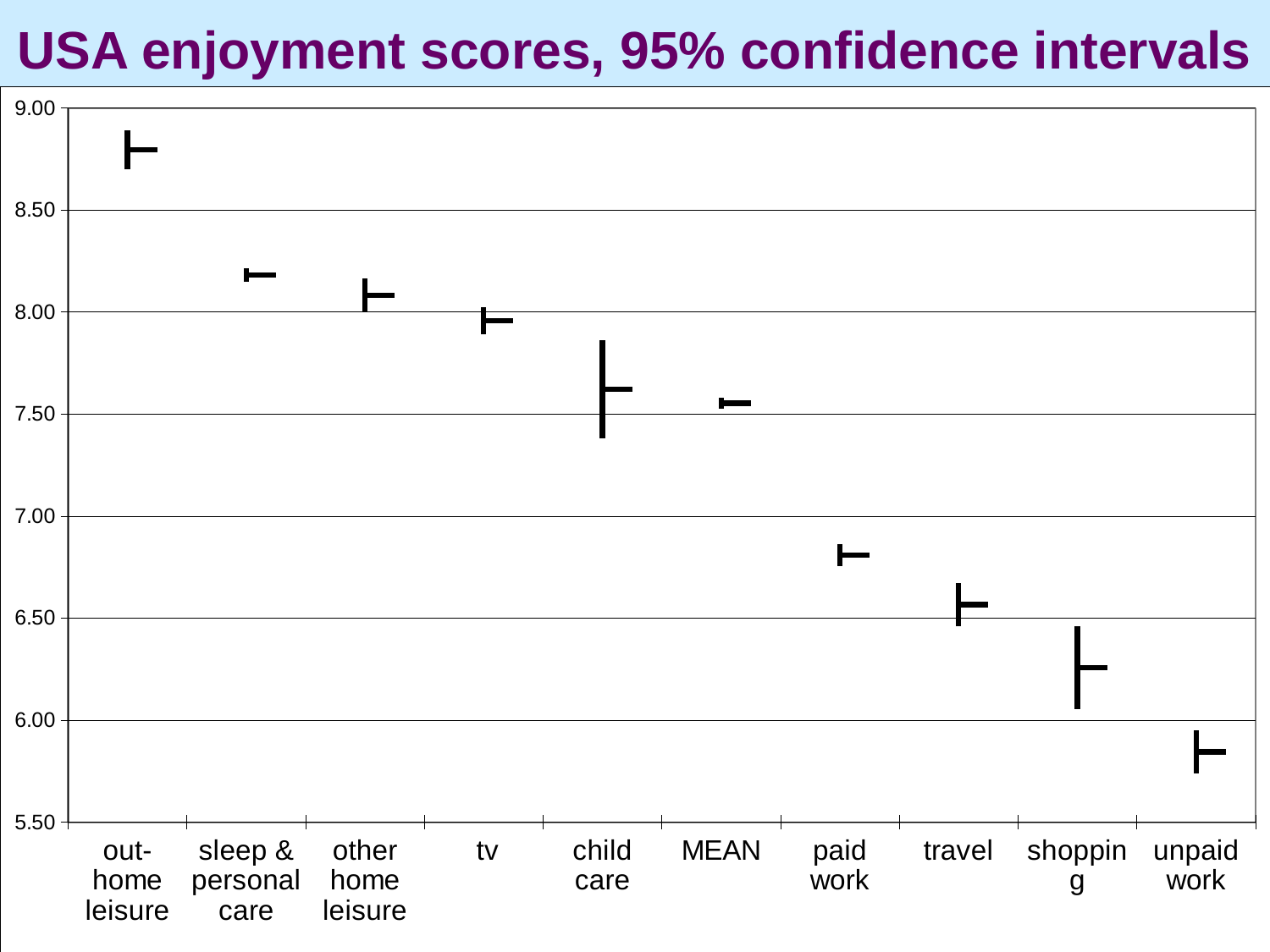
Is the enjoyment score for shopping greater or less than 6.00? greater How many activity categories are shown on the x axis? 10 Which category has the highest enjoyment score? out-home leisure What is the title of the chart? USA enjoyment scores, 95% confidence intervals Is the enjoyment score for unpaid work greater or less than 6.00? less Is the enjoyment score for paid work greater or less than 7.00? less Which category has the widest confidence interval? child care Do the enjoyment scores rise or fall moving from left to right along the x axis? fall Which has the higher enjoyment score, paid work or travel? paid work Which category has the lowest enjoyment score? unpaid work